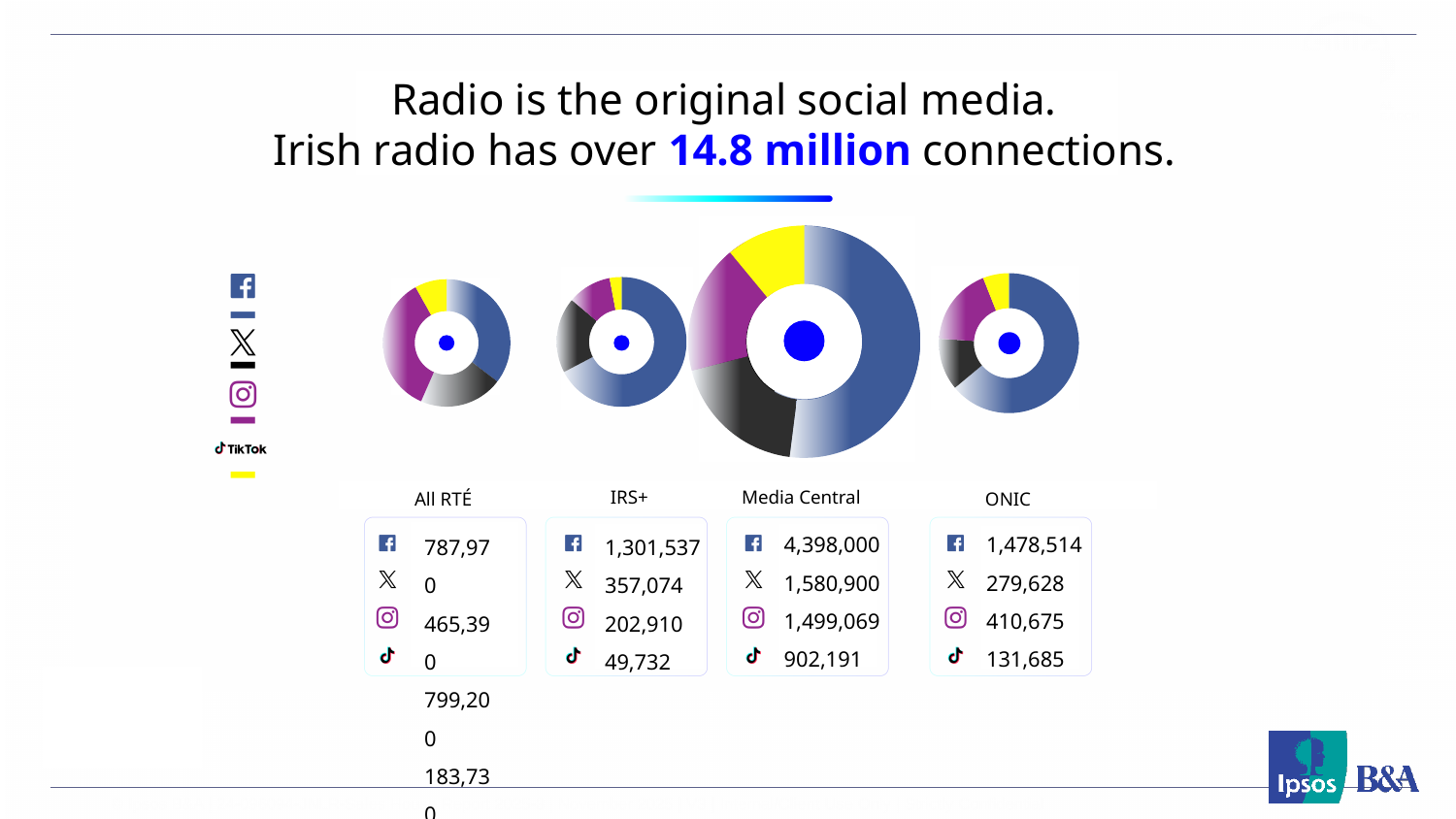
In the IRS+ chart, what is the value for X? 357,074 In the Media Central chart, which platform has the highest value? Facebook In the Media Central chart, what is the value for Facebook? 4,398,000 In the IRS+ chart, what is the value for TikTok? 49,732 In the ONIC chart, which is larger, the Instagram value or the X value? Instagram How many pie charts are shown on the slide? 4 What kind of chart is used to show the social media connections for each radio group? doughnut chart In the Media Central chart, what is the difference between the X value and the Instagram value? 81,831 What is the total of the four values shown for the ONIC chart? 2,300,502 In the ONIC chart, what is the value for Instagram? 410,675 According to the legend on the left, which platform is shown in yellow? TikTok In the IRS+ chart, which platform has the lowest value? TikTok